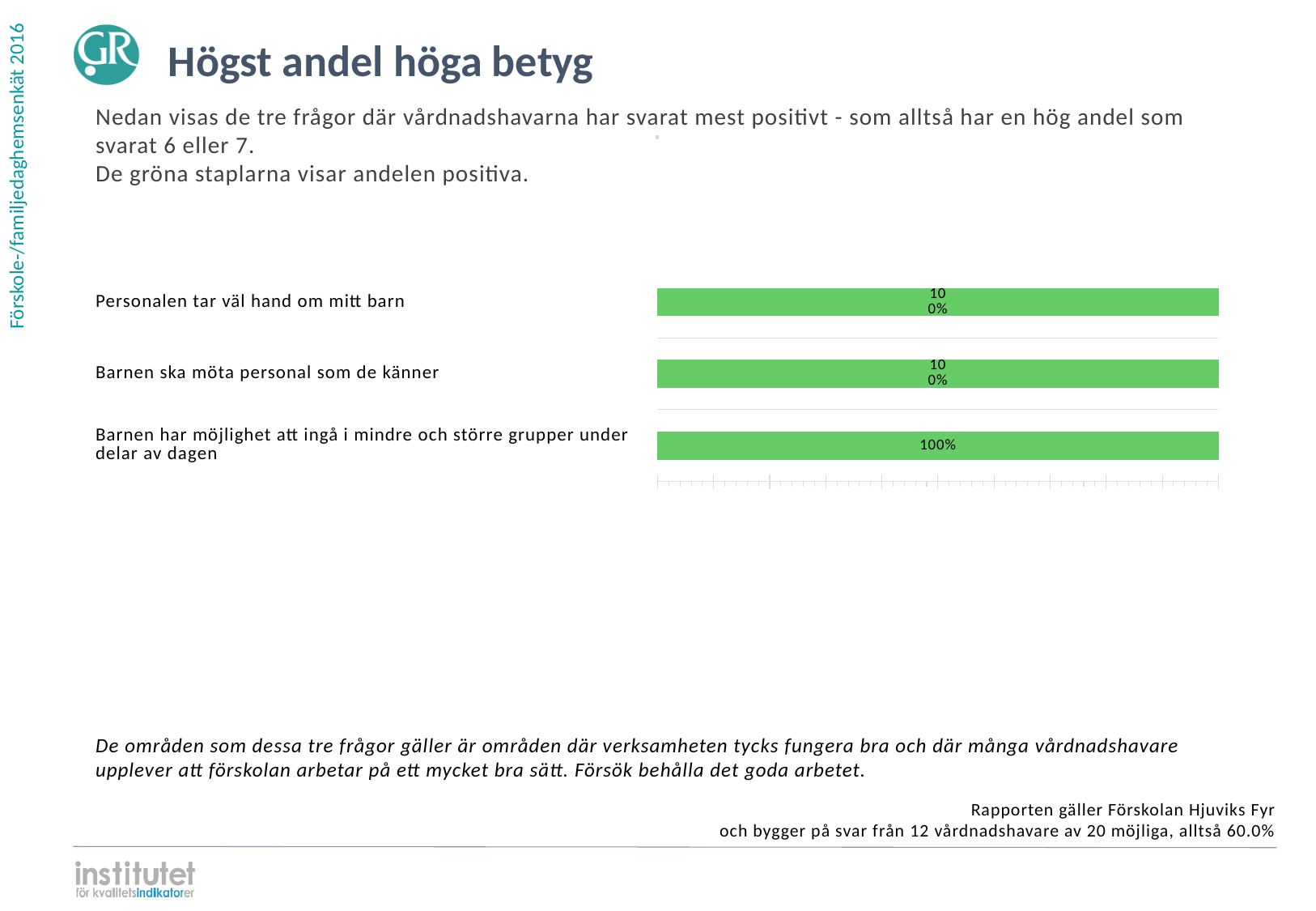
What is the value for "Personalen tar väl hand om mitt barn"? 100% What is the value for "Barnen ska möta personal som de känner"? 100% Do all three categories in the chart have the same value? Yes What kind of chart is shown on the slide? Bar chart How many categories are shown in the chart? 3 What is the difference between the value for "Barnen ska möta personal som de känner" and the value for "Barnen har möjlighet att ingå i mindre och större grupper under delar av dagen"? 0% What colour are the bars in the chart? Green What is the title of the slide containing the chart? Högst andel höga betyg What is the value for "Barnen har möjlighet att ingå i mindre och större grupper under delar av dagen"? 100% What is the difference between the value for "Personalen tar väl hand om mitt barn" and the value for "Barnen ska möta personal som de känner"? 0%